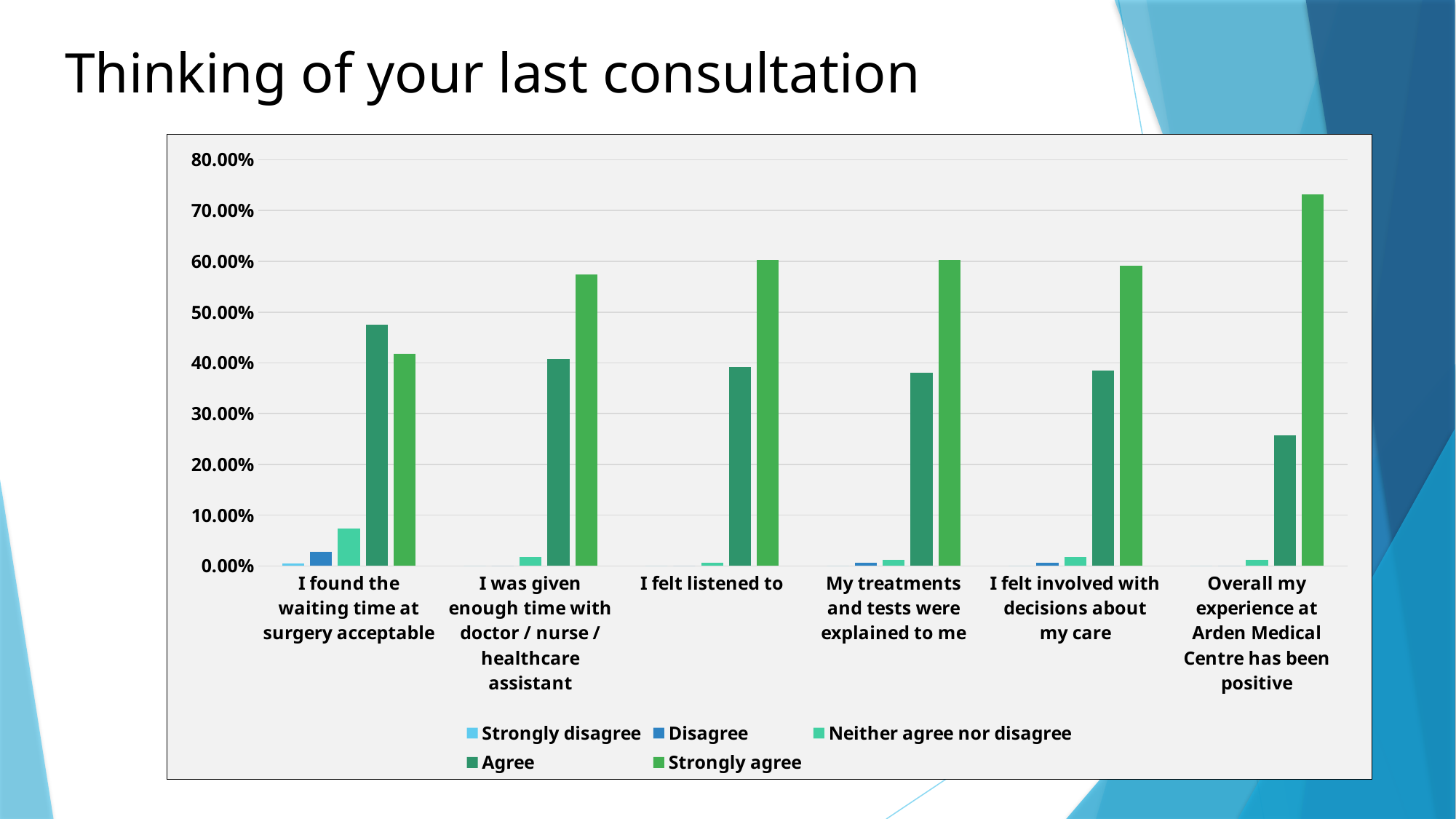
What is the title of the slide containing the chart? Thinking of your last consultation Which statement has the highest 'Agree' value? I found the waiting time at surgery acceptable Which statement has the highest 'Strongly agree' value? Overall my experience at Arden Medical Centre has been positive Is the 'Strongly agree' value for 'Overall my experience at Arden Medical Centre has been positive' greater or less than 70.00%? greater Is the 'Agree' value for 'Overall my experience at Arden Medical Centre has been positive' greater or less than 30.00%? less How many statement categories are shown along the x axis? 6 Is the 'Strongly agree' value for 'I was given enough time with doctor / nurse / healthcare assistant' greater or less than 50.00%? greater For 'I found the waiting time at surgery acceptable', which is larger: 'Agree' or 'Strongly agree'? Agree How many series does the legend list? 5 Which statement has the lowest 'Strongly agree' value? I found the waiting time at surgery acceptable What kind of chart is shown on the slide? Bar chart